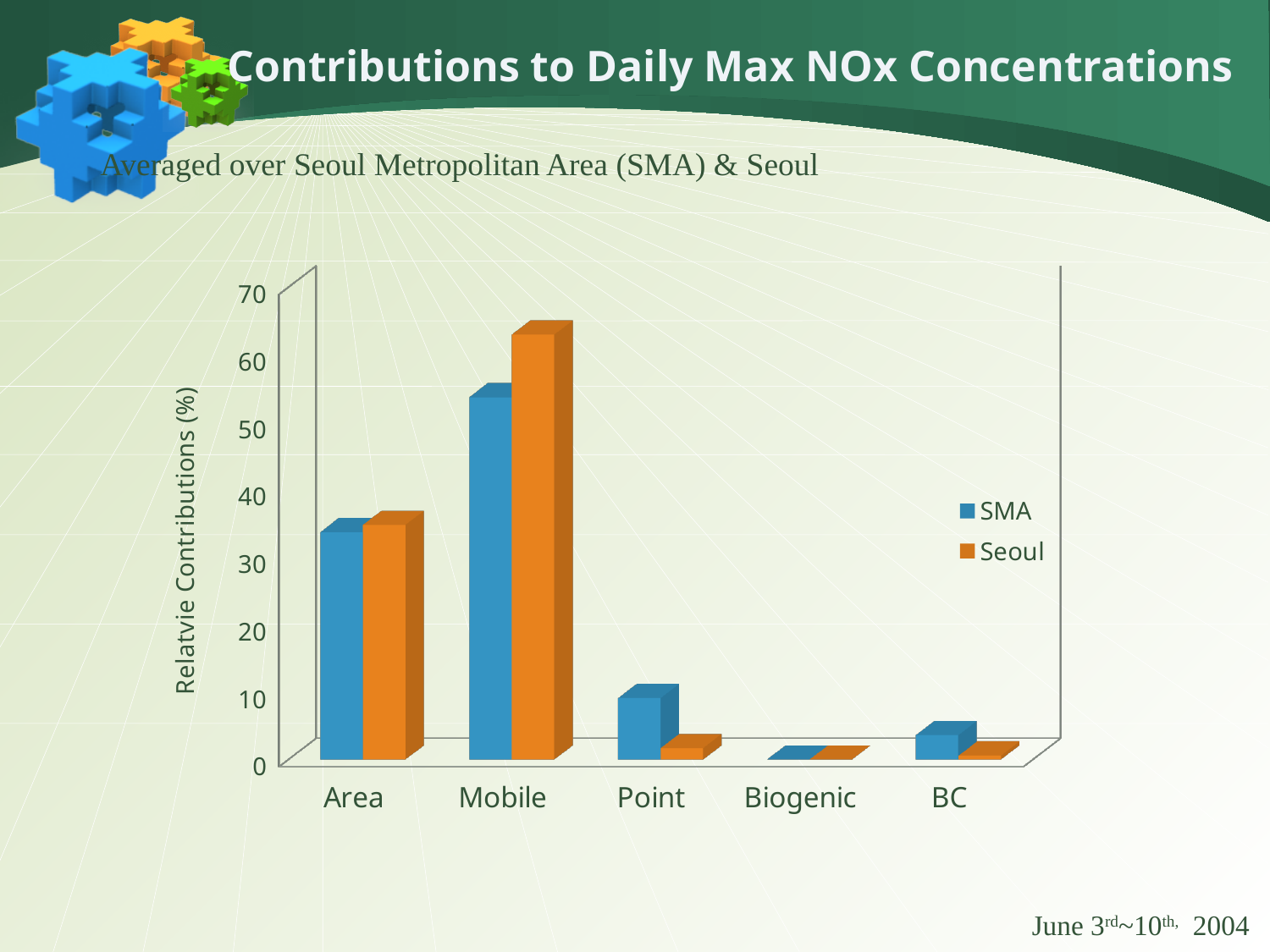
How many categories are shown on the x axis of the chart? 5 How many series does the chart's legend list? 2 What kind of chart is shown on the slide? bar chart For the Point category, which series has the larger value, SMA or Seoul? SMA What is the label of the chart's vertical axis? Relatvie Contributions (%) Which category has the highest value for the Seoul series? Mobile For the Mobile category, which series has the larger value, SMA or Seoul? Seoul Is the SMA value for Mobile greater or less than 50? greater Which category has the lowest value for the SMA series? Biogenic Is the SMA value for Area greater or less than 40? less Is the Seoul value for Point greater or less than 10? less Which category has the highest value for the SMA series? Mobile